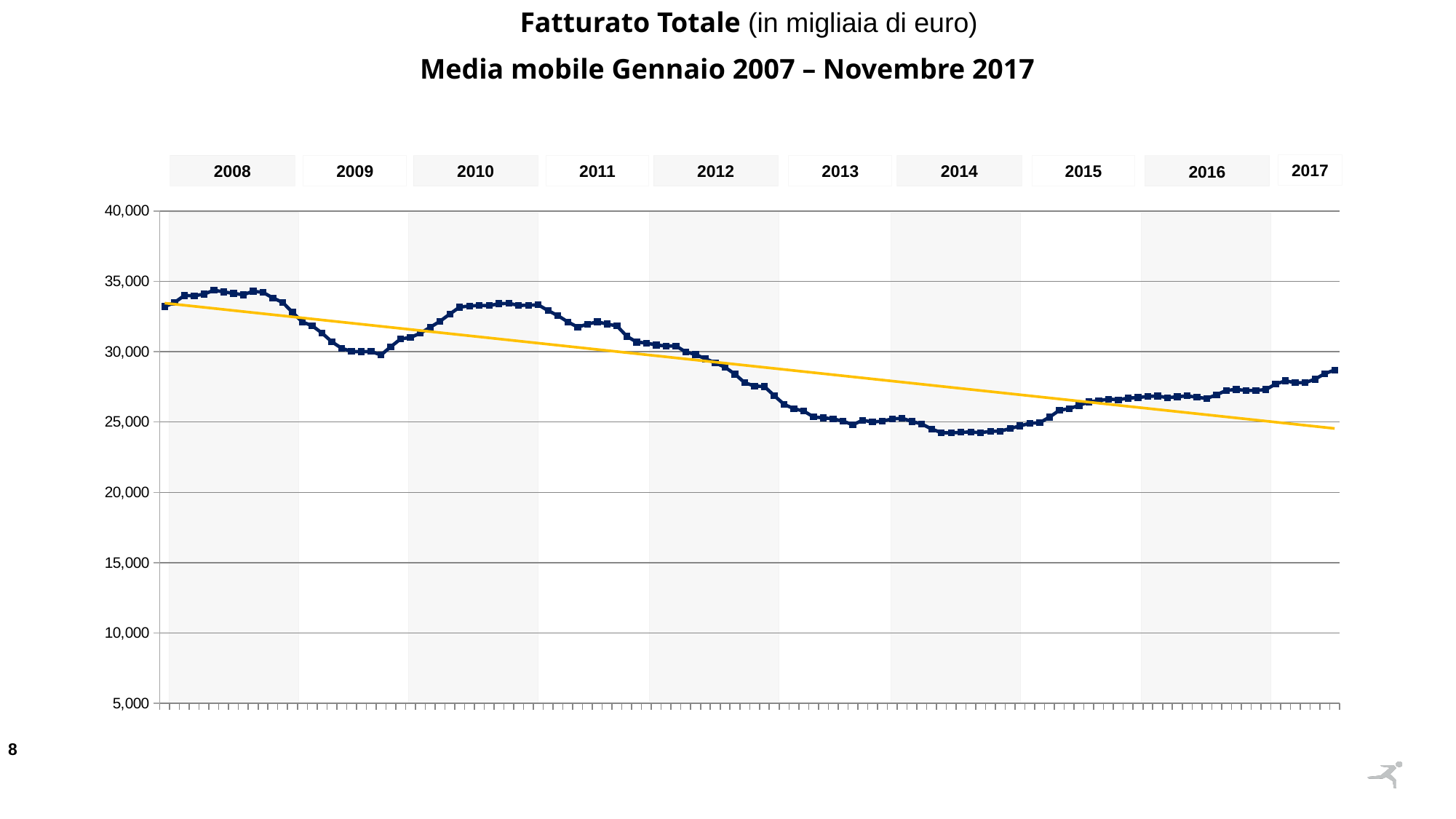
Is the value of the moving average at the start of 2008 greater or less than 30,000? greater What is the highest value shown on the vertical axis? 40,000 Does the moving average rise or fall between 2014 and 2017? rise How many year labels are shown along the top of the chart? 10 Does the yellow trend line rise or fall from left to right? fall In which year does the moving average reach its lowest level? 2014 What is the title of the chart on the slide? Fatturato Totale (in migliaia di euro) – Media mobile Gennaio 2007 – Novembre 2017 What kind of chart is shown on the slide? line chart Does the moving average rise or fall between 2010 and 2014? fall Is the value of the moving average at the end of 2017 greater or less than 30,000? less Is the value of the moving average during 2014 greater or less than 30,000? less